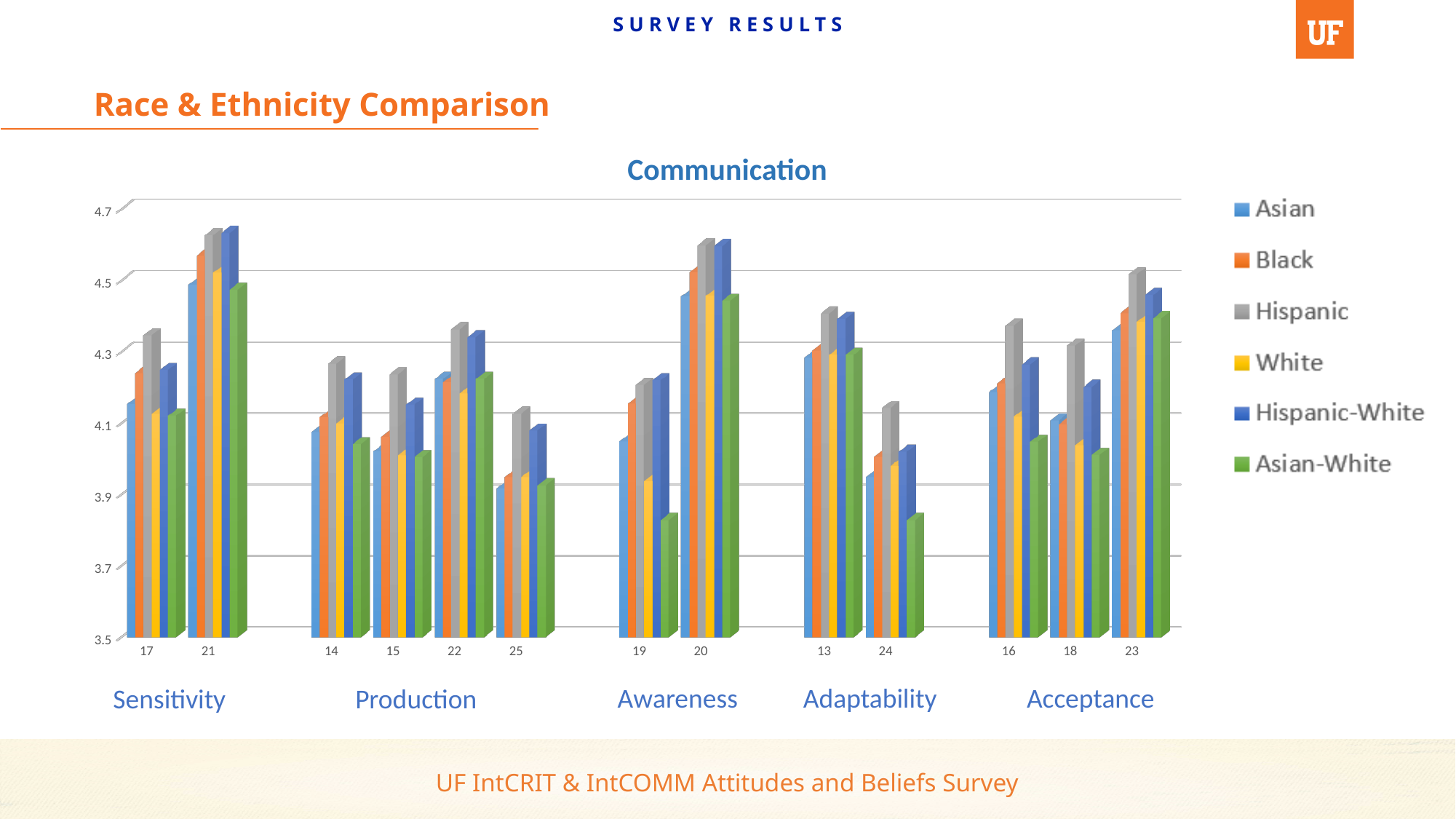
How many numbered categories are plotted along the x axis? 13 Is the Hispanic-White value for category 21 greater or less than 4.5? greater Is the Hispanic value for category 17 greater or less than 4.3? greater Which is larger: the Hispanic value for category 21 or the Hispanic value for category 14? category 21 What is the title of the chart? Communication Is the Asian-White value for category 19 greater or less than 3.9? less Which series has the highest value for category 16? Hispanic How many series does the legend list? 6 Which legend entry is shown in gray? Hispanic What kind of chart is shown on the slide? bar chart Which series has the lowest value for category 24? Asian-White